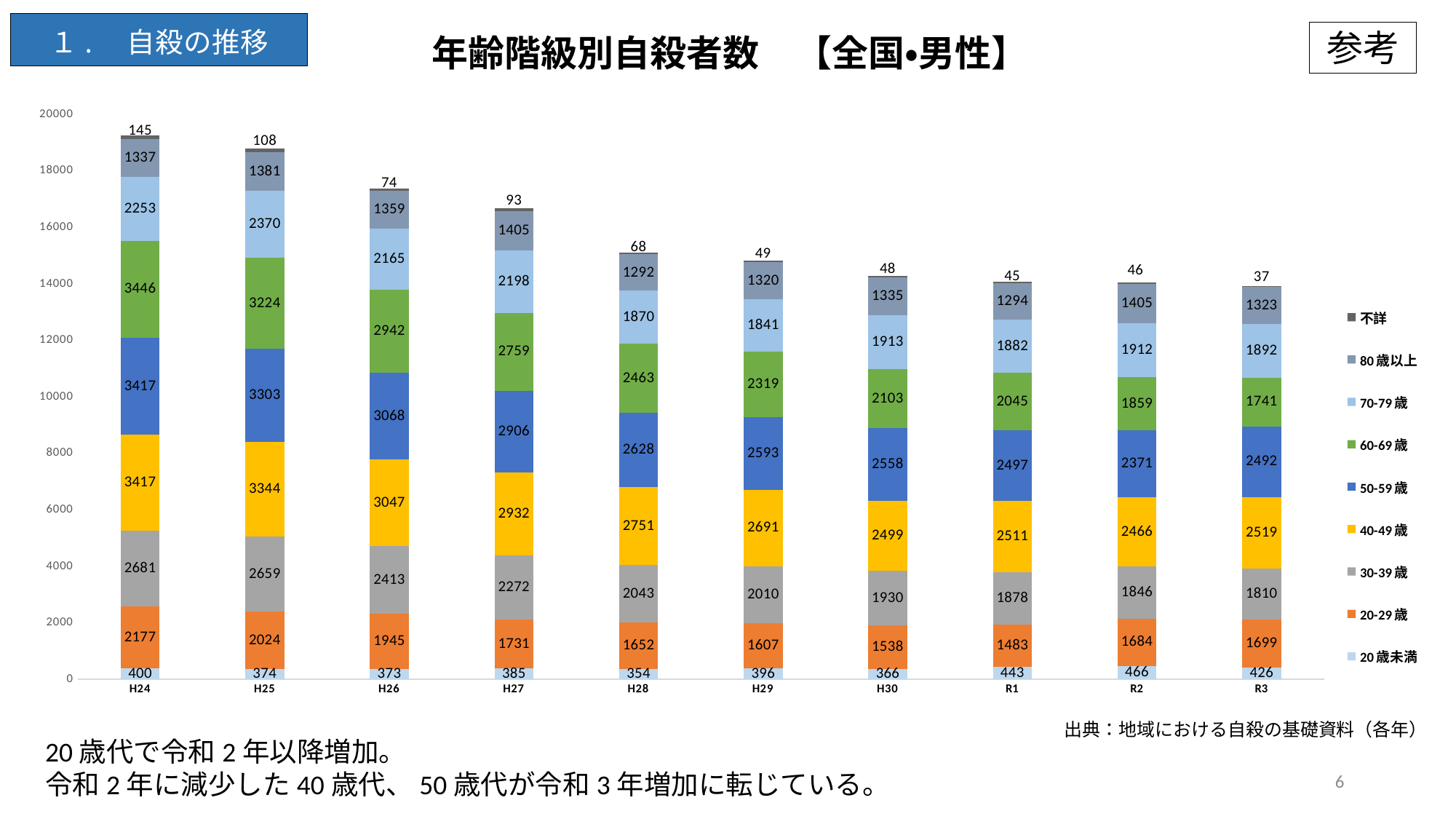
How many series does the legend list? 9 What is the value for the 不詳 series in H25? 108 In which year is the 60-69歳 value the highest? H24 What is the value for the 40-49歳 series in H24? 3417 What is the value for the 20-29歳 series in R3? 1699 Does the 不詳 value generally rise or fall from H24 to R3? Fall How many years (categories) are shown on the x axis? 10 Which is larger, the 30-39歳 value for H26 or for H27? H26 What is the difference between the 50-59歳 values for R3 and R2? 121 What is the total of the stacked bar for R3? 13939 What kind of chart is shown on the slide? Stacked bar chart In which year is the 20歳未満 value the lowest? H28